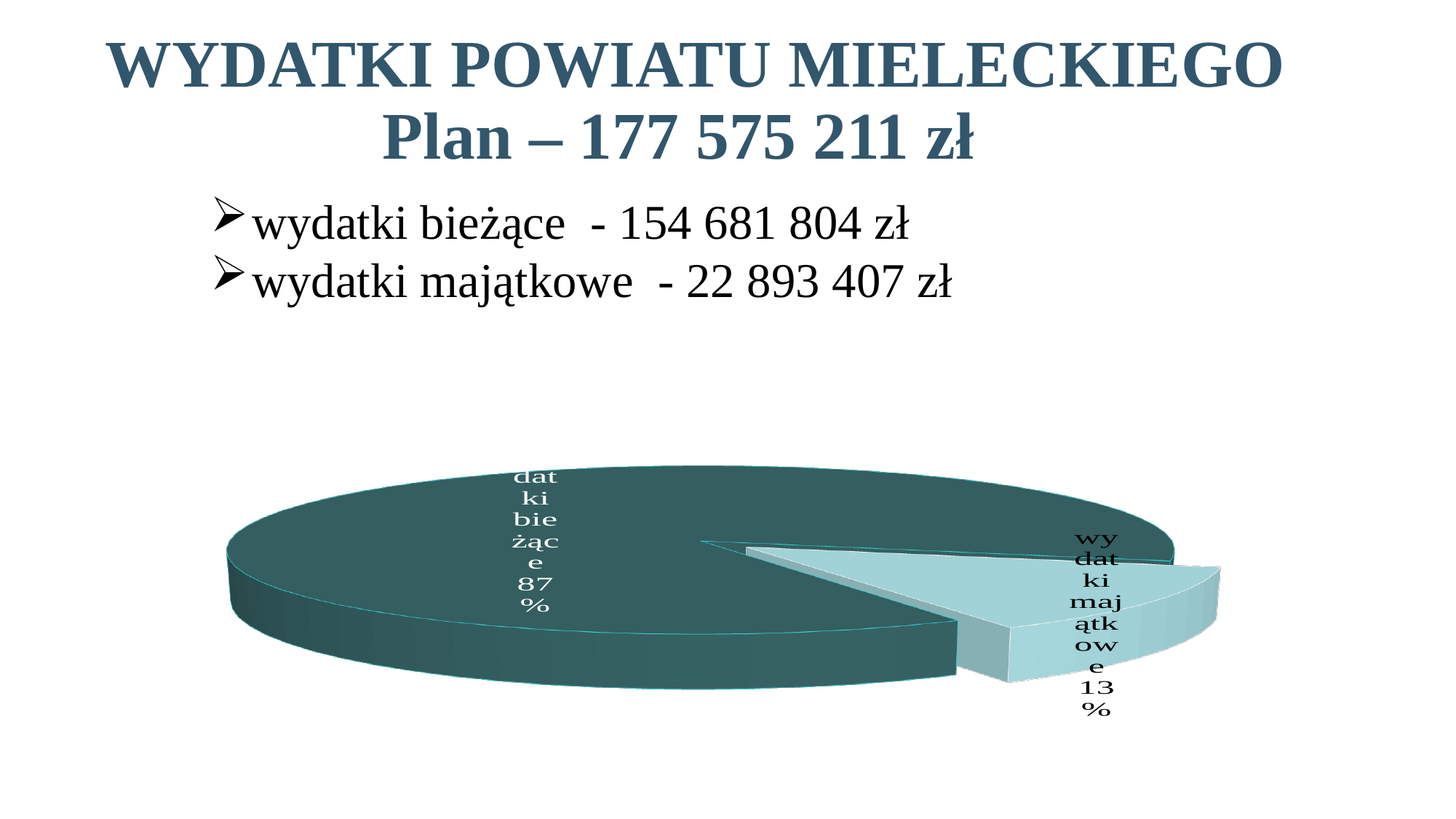
Which slice of the pie chart is pulled out (exploded) from the rest of the pie? wydatki majątkowe What share of the pie does the slice for wydatki majątkowe represent? 13% Which slice of the pie chart is the smallest? wydatki majątkowe What share of the pie does the slice for wydatki bieżące represent? 87% Which slice of the pie chart is the largest? wydatki bieżące Is the share for wydatki majątkowe greater or less than 50%? less What kind of chart is shown on the slide? pie chart What is the total plan amount stated in the slide title? 177 575 211 zł How many slices does the pie chart have? 2 Which is larger in the pie chart, wydatki bieżące or wydatki majątkowe? wydatki bieżące What is the difference in percentage points between the wydatki bieżące slice and the wydatki majątkowe slice? 74